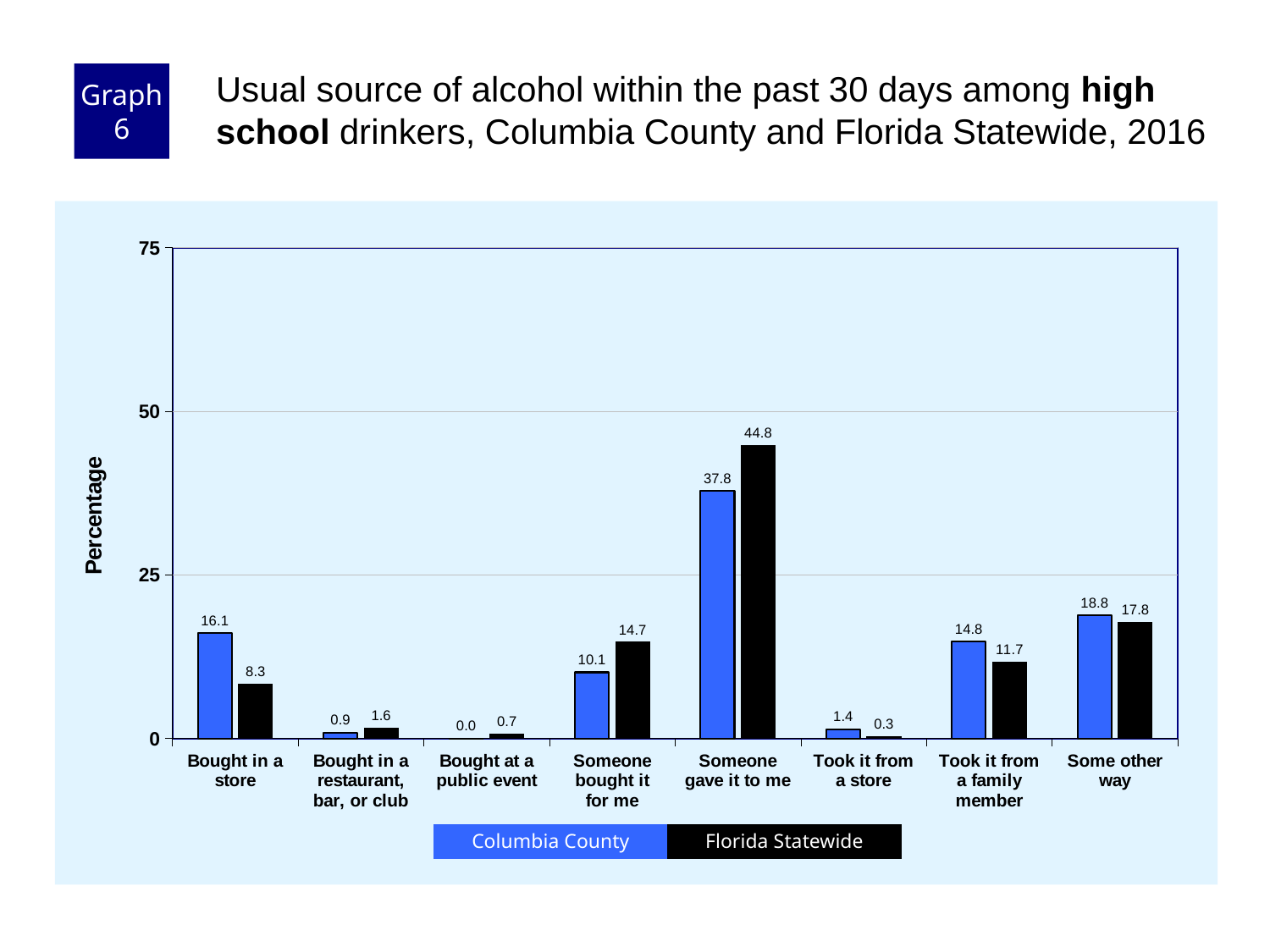
How many series does the legend list? 2 What is the Columbia County value for "Took it from a family member"? 14.8 What is the Columbia County value for "Someone gave it to me"? 37.8 Is the Florida Statewide value for "Someone gave it to me" greater or less than 50? less What kind of chart is shown on the slide? bar chart Which is larger for "Took it from a family member": Columbia County or Florida Statewide? Columbia County Which category has the lowest Columbia County value? Bought at a public event Which category has the highest Florida Statewide value? Someone gave it to me What is the Florida Statewide value for "Bought in a store"? 8.3 What is the difference between the Florida Statewide and Columbia County values for "Someone gave it to me"? 7.0 How many categories are shown on the x axis? 8 What is the label on the y axis? Percentage